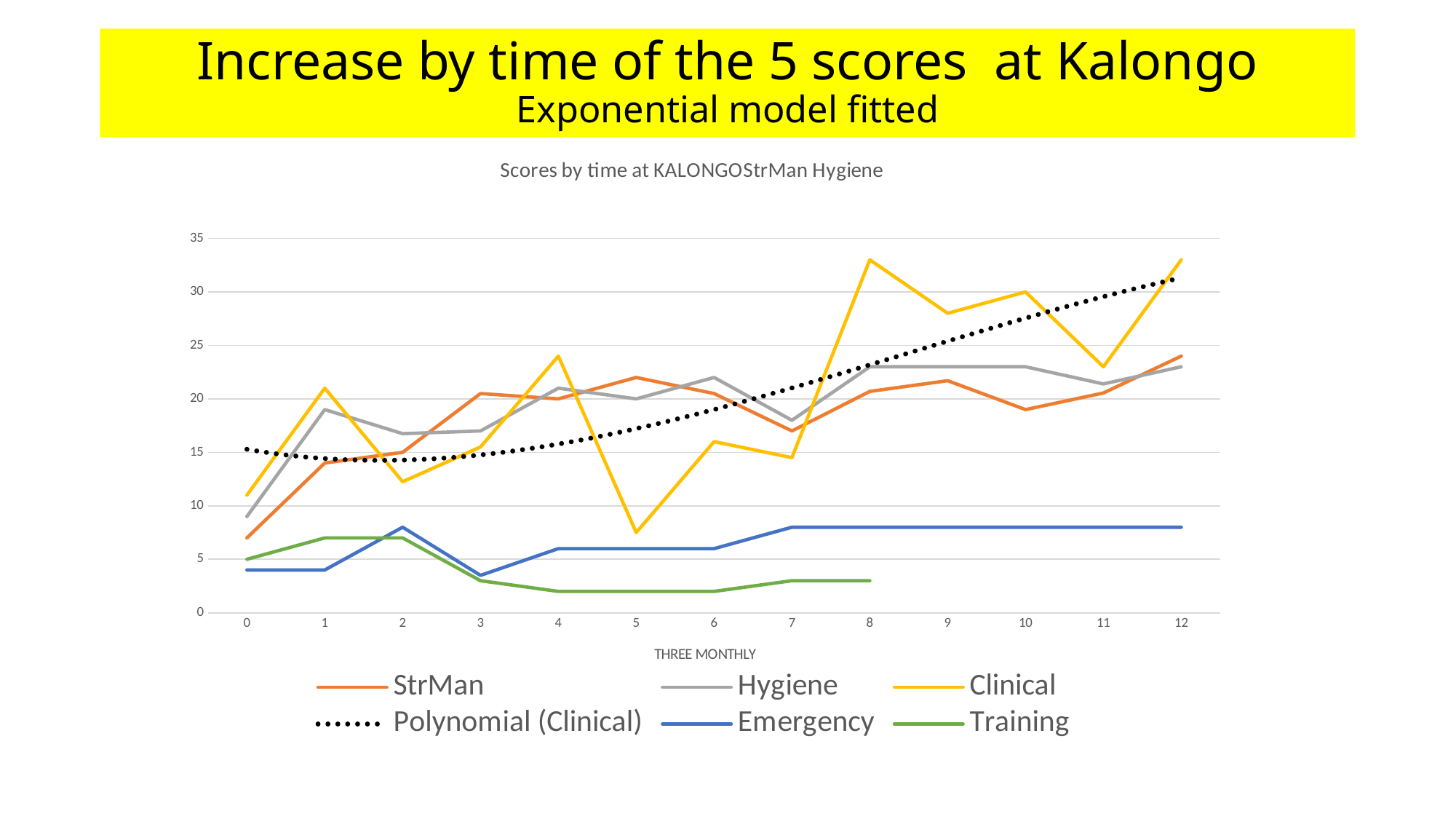
Is the Clinical value at time point 8 greater or less than 30? greater Which series has the lowest value at time point 4? Training At time point 5, which is larger, the StrMan value or the Clinical value? StrMan Does the Emergency series rise or fall overall from time point 0 to time point 12? rise At time point 12, which is larger, the Clinical value or the StrMan value? Clinical Is the Training value at time point 4 greater or less than 5? less Is the Clinical value at time point 5 greater or less than 10? less What kind of chart is shown on the slide? line chart How many time points are shown on the x axis? 13 How many series does the legend list? 6 Which series has the highest value at time point 8? Clinical